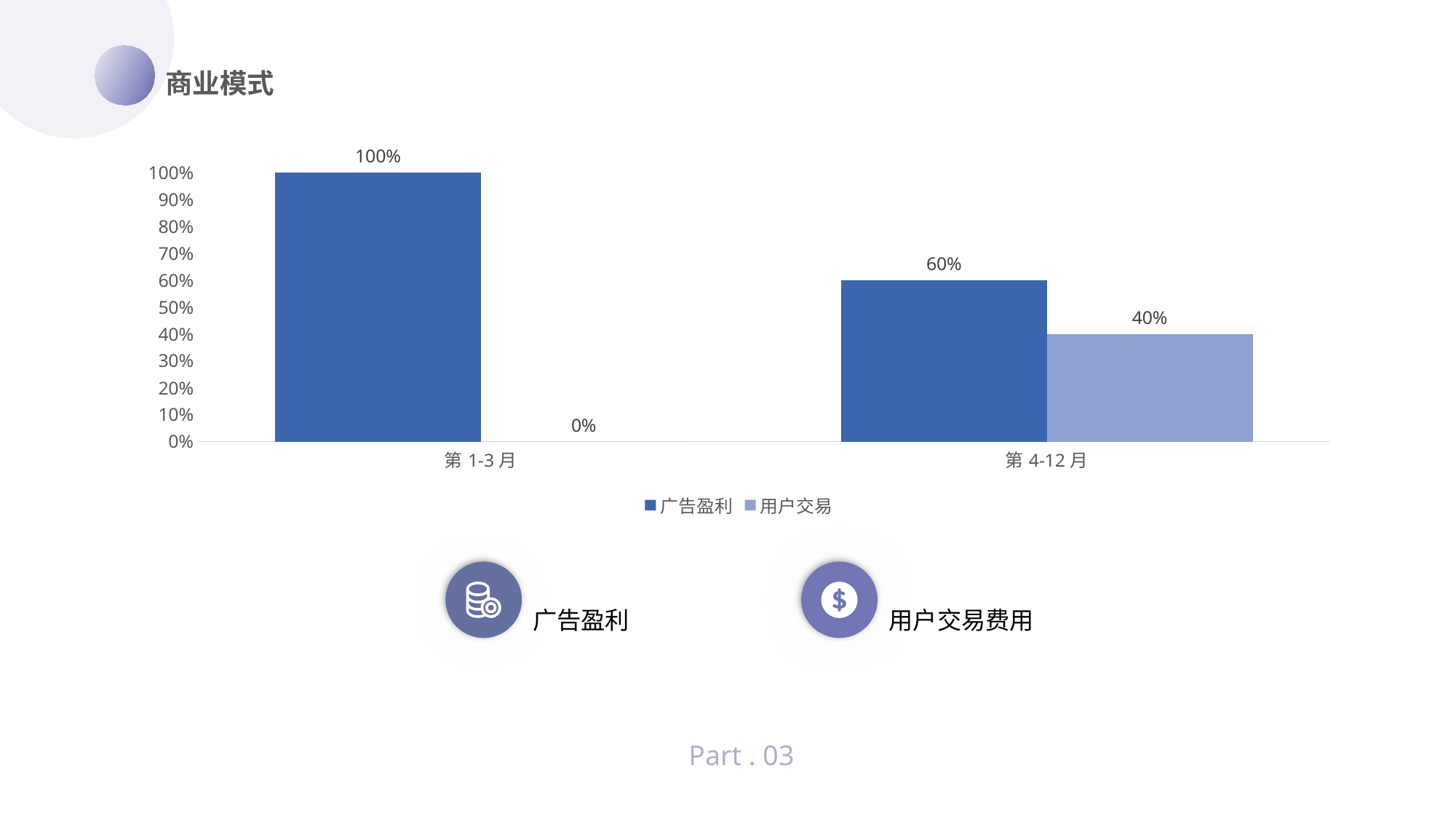
How many series does the legend list? 2 What is the value of 用户交易 for 第 4-12 月? 40% What is the value of 用户交易 for 第 1-3 月? 0% Which category has the highest 广告盈利 value? 第 1-3 月 What is the difference between the 广告盈利 values for 第 1-3 月 and 第 4-12 月? 40% For 第 4-12 月, which is larger: 广告盈利 or 用户交易? 广告盈利 How many categories are shown on the x axis? 2 What is the value of 广告盈利 for 第 4-12 月? 60% Which category has the lowest 用户交易 value? 第 1-3 月 What kind of chart is shown on the slide? Bar chart What is the value of 广告盈利 for 第 1-3 月? 100% What is the difference between 广告盈利 and 用户交易 for 第 4-12 月? 20%